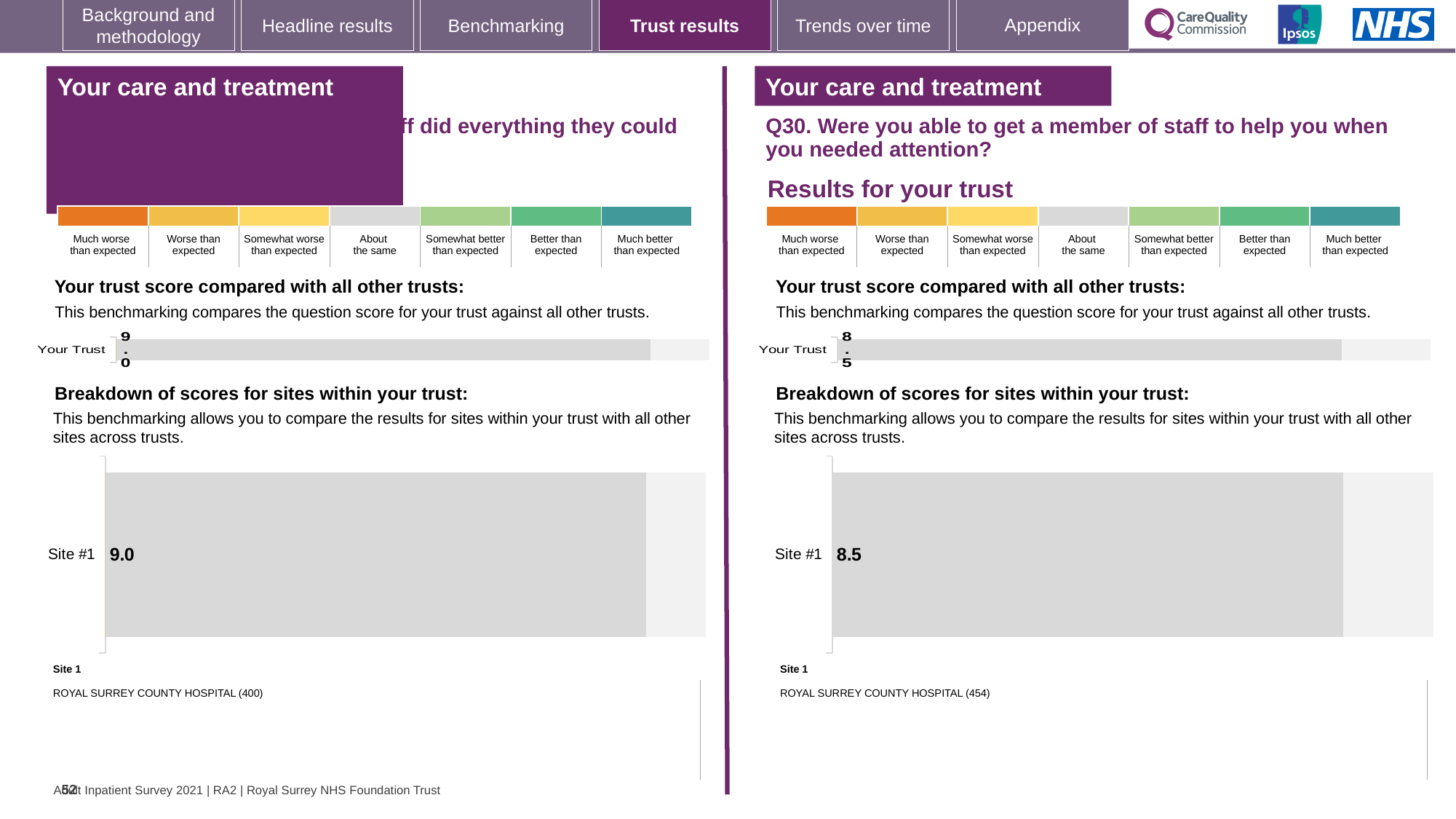
What type of chart is used to show the Your Trust score on the left panel? bar chart On the right panel (Q30), which site is listed as Site 1 below the breakdown chart? ROYAL SURREY COUNTY HOSPITAL (454) How many sites are shown in the 'Breakdown of scores for sites within your trust' chart on the right panel (Q30)? 1 On the left panel, which site is listed as Site 1 below the breakdown chart? ROYAL SURREY COUNTY HOSPITAL (400) Is the Site #1 score on the right panel (Q30) greater or less than the Site #1 score on the left panel? less On the right panel (Q30), what is the score shown for Your Trust in the 'Your trust score compared with all other trusts' chart? 8.5 On the left panel, what is the score shown for Your Trust in the 'Your trust score compared with all other trusts' chart? 9.0 On the left panel, what is the score for Site #1 in the 'Breakdown of scores for sites within your trust' chart? 9.0 Which panel shows the higher Your Trust score, the left panel or the right panel (Q30)? the left panel On the right panel (Q30), what is the score for Site #1 in the 'Breakdown of scores for sites within your trust' chart? 8.5 What is the difference between the Your Trust score on the left panel and the Your Trust score on the right panel (Q30)? 0.5